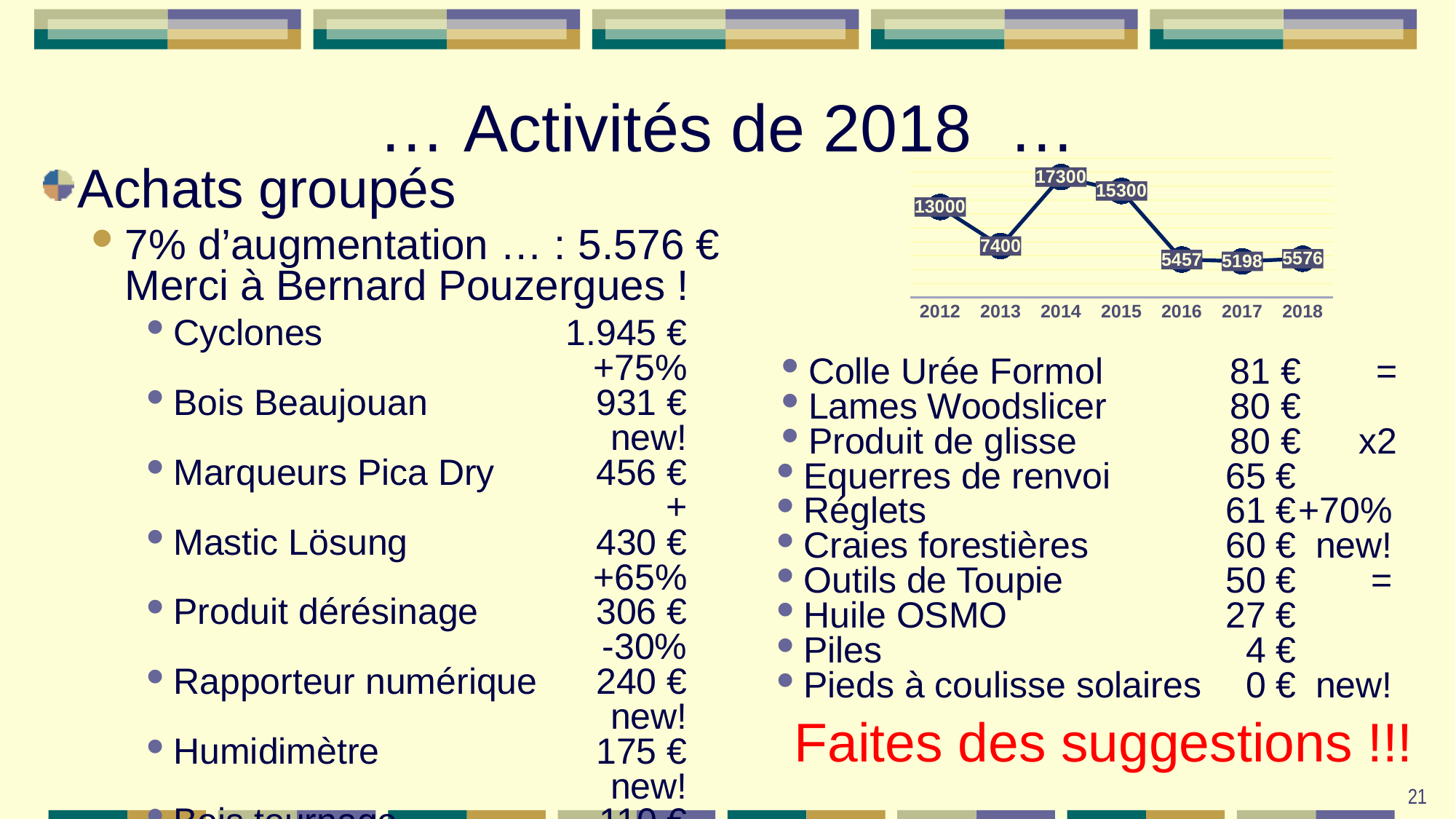
What is the difference between the values for 2018 and 2017 in the line chart? 378 How many years are plotted on the x axis of the line chart? 7 Do the values in the line chart rise or fall from 2015 to 2016? fall Which year has the highest value in the line chart? 2014 What kind of chart is shown on the slide? line chart What is the value plotted for 2014 in the line chart? 17300 What is the first year shown on the x axis of the line chart? 2012 Which is larger in the line chart, the value for 2012 or the value for 2013? 2012 Which year has the lowest value in the line chart? 2017 What is the difference between the values for 2014 and 2015 in the line chart? 2000 What is the value plotted for 2013 in the line chart? 7400 What is the value plotted for 2018 in the line chart? 5576